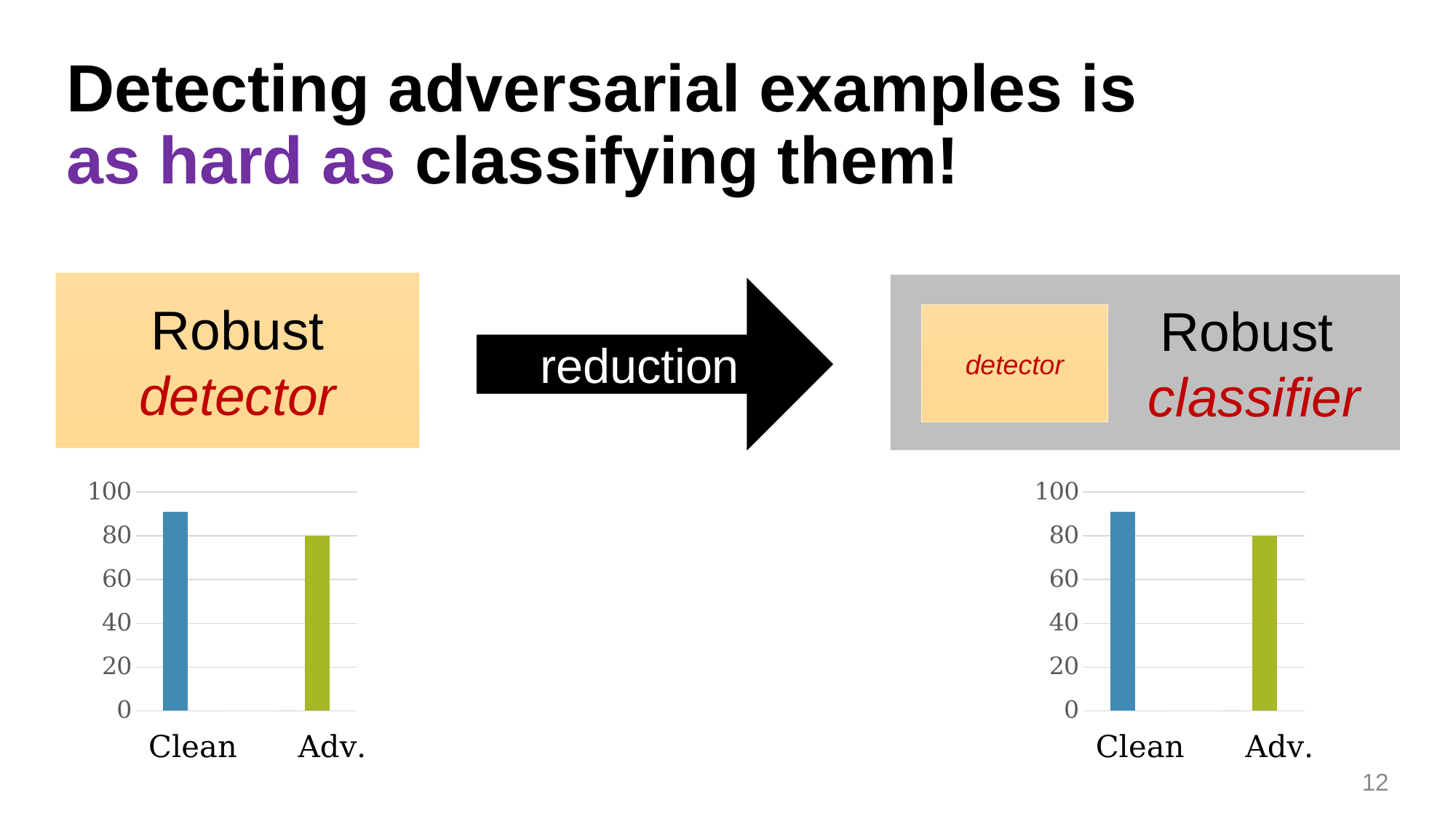
What kind of chart is the left chart? bar chart How many categories are shown in the right chart? 2 In the left chart, is the value for Clean greater or less than 80? greater In the left chart under 'Robust detector', what is the value for Adv.? 80 In the left chart, what colour is the Adv. bar? green In the right chart, which category has the lowest value? Adv. What is the maximum value shown on the y axis of the left chart? 100 In the right chart under 'Robust classifier', what is the value for Adv.? 80 In the right chart, do the values rise or fall from Clean to Adv.? fall In the right chart, is the value for Clean greater or less than 100? less In the left chart, which category has the highest value? Clean In the left chart, which is larger, the value for Clean or the value for Adv.? Clean